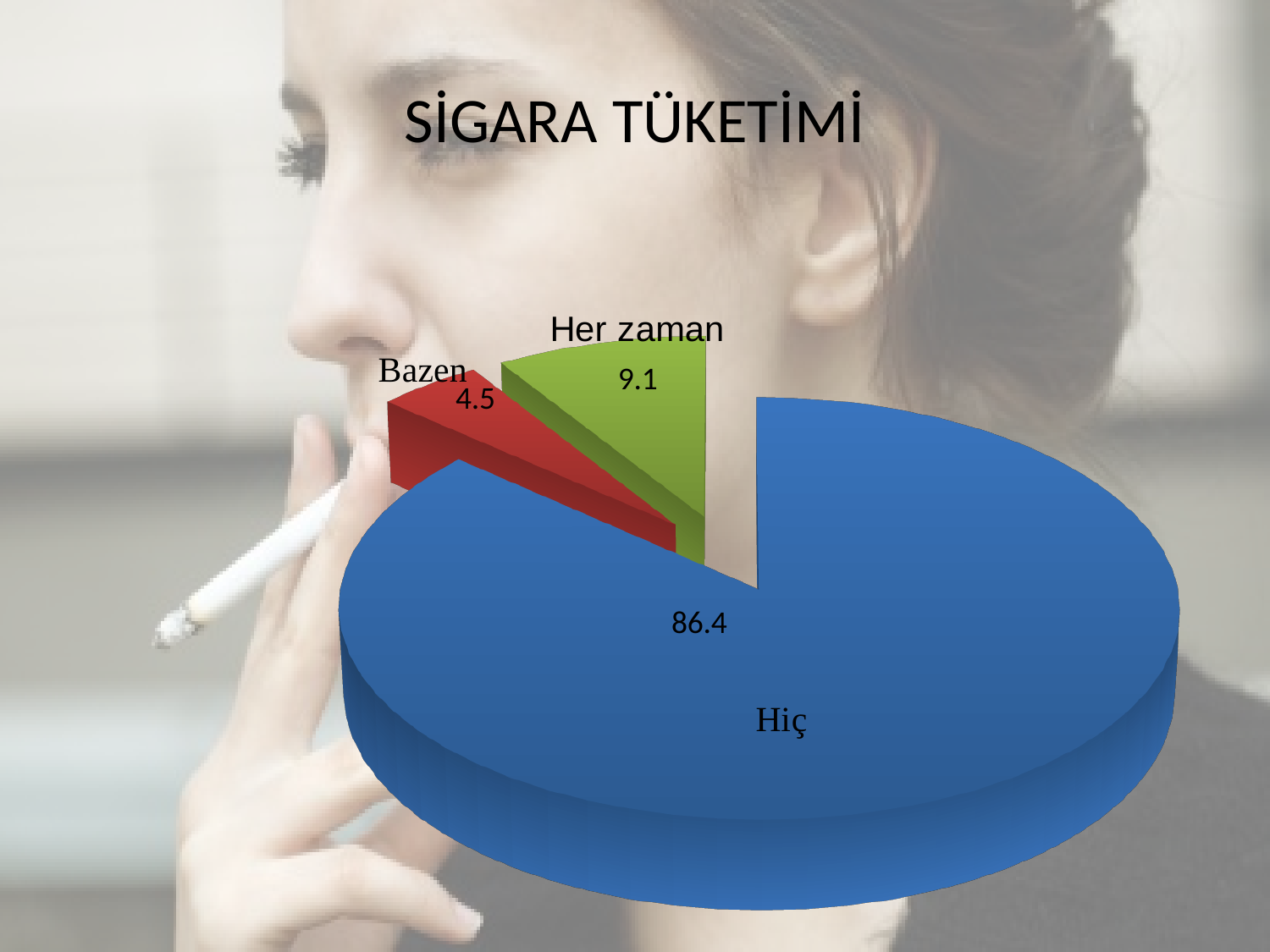
Which is larger, the value for Her zaman or the value for Bazen? Her zaman What is the value for Bazen? 4.5 What is the value for Her zaman? 9.1 What is the difference between the values for Hiç and Her zaman? 77.3 What is the difference between the values for Her zaman and Bazen? 4.6 How many slices does the pie chart have? 3 What is the value for Hiç? 86.4 What colour is the Hiç slice? blue Which category has the smallest slice? Bazen What is the title of the slide containing the chart? SİGARA TÜKETİMİ What kind of chart is shown on the slide? pie chart Which category has the largest slice? Hiç